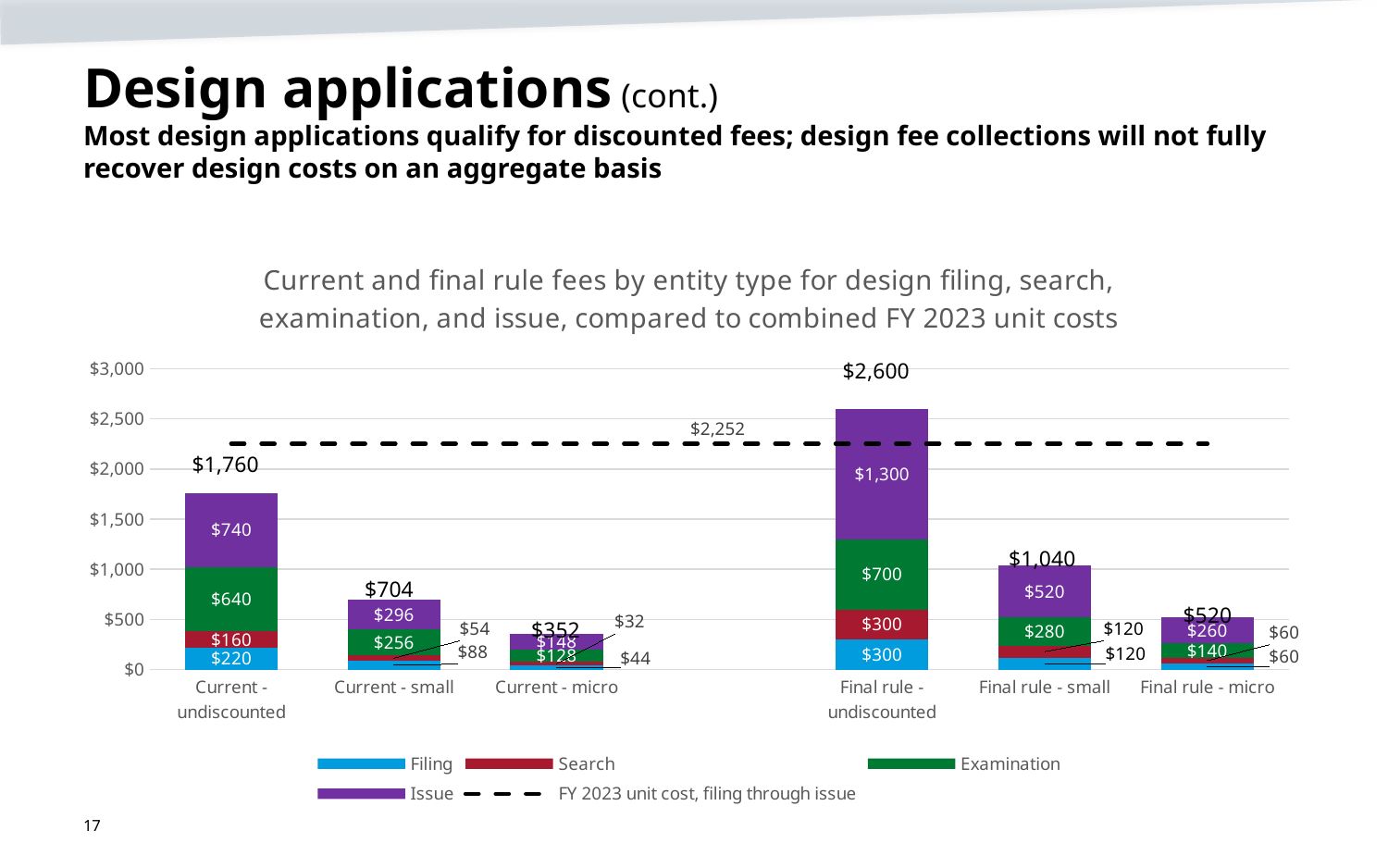
What is the FY 2023 unit cost, filing through issue, shown by the dashed line? $2,252 What kind of chart is shown on the slide? Stacked bar chart Is the total fee for Final rule - undiscounted greater or less than $2,500? greater How many entries does the chart's legend list? 5 Which is larger, the Examination fee for Current - undiscounted or the Examination fee for Final rule - undiscounted? Final rule - undiscounted What is the difference between the total fee for Final rule - undiscounted and the total fee for Current - undiscounted? $840 Which category has the highest total fee? Final rule - undiscounted What is the Filing fee for the Final rule - small bar? $120 What is the total fee shown above the Current - undiscounted bar? $1,760 What is the Issue fee for the Final rule - undiscounted bar? $1,300 How many entity-type categories are shown along the x axis of the chart? 6 Which category has the lowest total fee? Current - micro